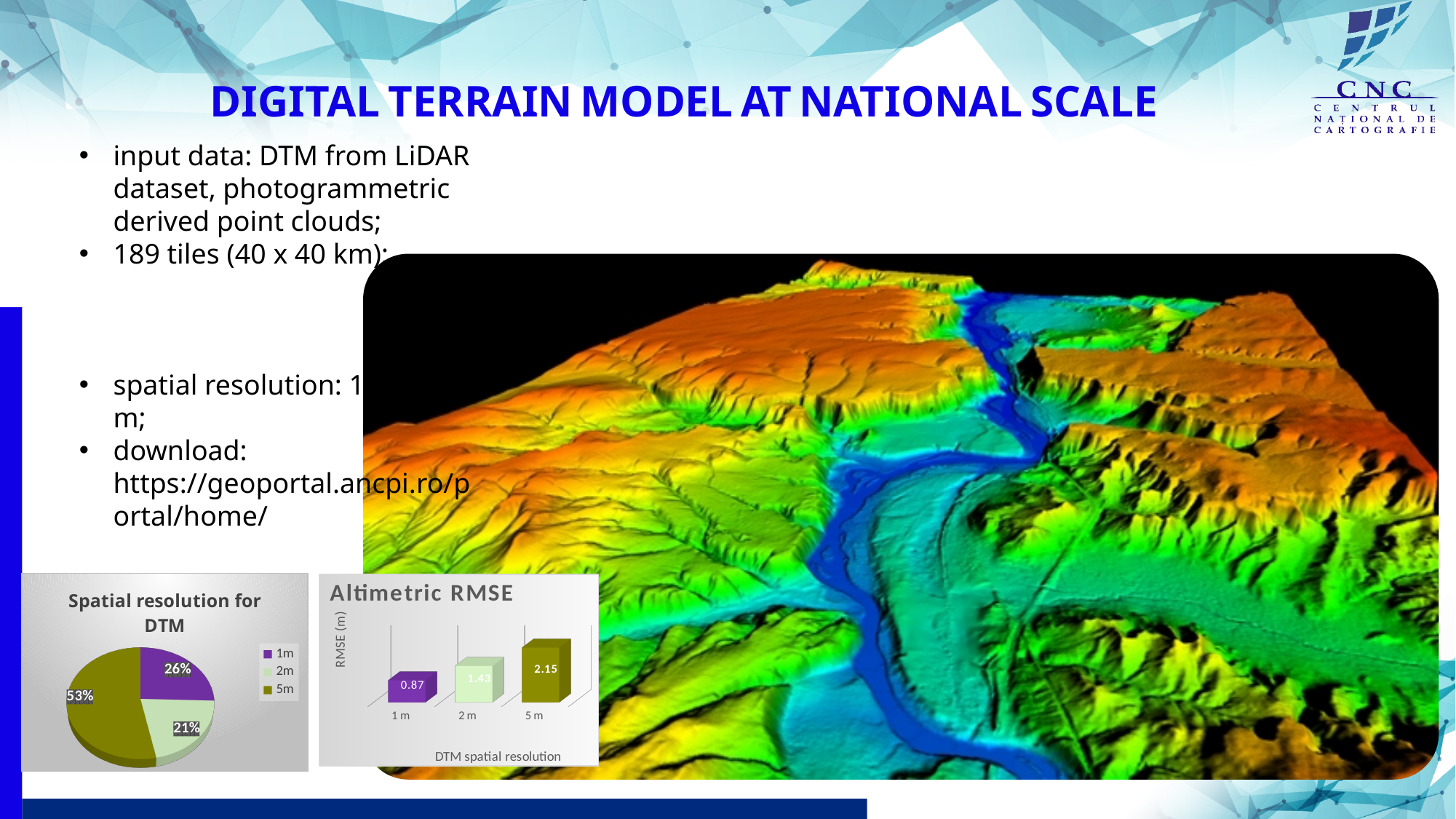
In the 'Altimetric RMSE' chart, do the values rise or fall as the resolution goes from 1 m to 5 m? Rise In the 'Spatial resolution for DTM' pie chart, which resolution has the largest share? 5m What kind of chart is 'Spatial resolution for DTM'? Pie chart In the 'Spatial resolution for DTM' pie chart, what share does the 5m slice have? 53% In the 'Spatial resolution for DTM' chart, what is the difference between the 1m and 2m shares? 5% In the 'Altimetric RMSE' chart, what is the RMSE for 5 m? 2.15 In the 'Spatial resolution for DTM' pie chart, which resolution has the smallest share? 2m In the 'Spatial resolution for DTM' pie chart, what share does the 1m slice have? 26% In the 'Spatial resolution for DTM' pie chart, how many slices are there? 3 In the 'Altimetric RMSE' chart, what is the RMSE for 2 m? 1.43 In the 'Altimetric RMSE' chart, which resolution has the lowest RMSE? 1 m In the 'Altimetric RMSE' chart, what is the difference between the RMSE for 5 m and 1 m? 1.28